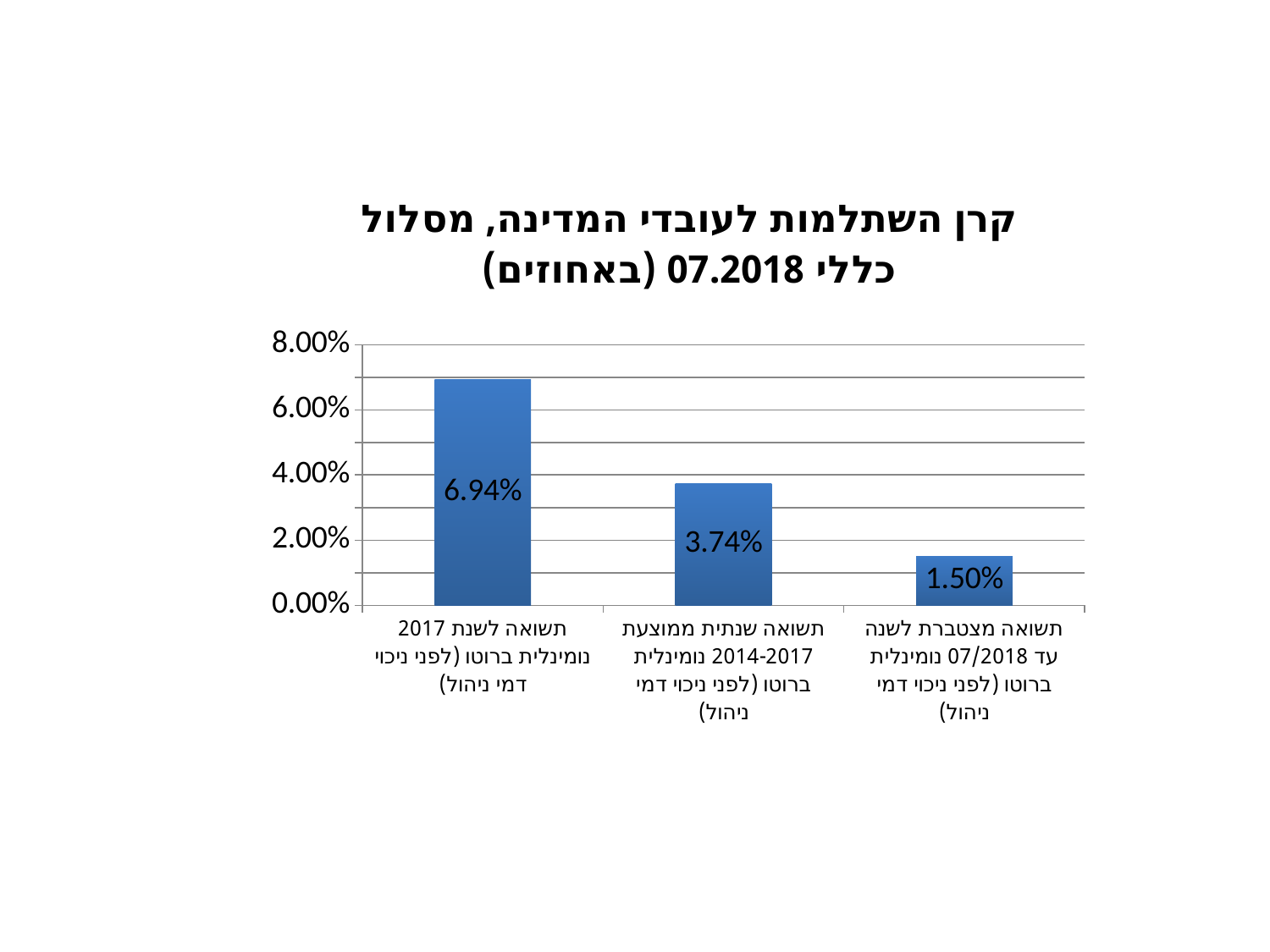
What is the value for the 2017 nominal gross return (תשואה לשנת 2017)? 6.94% Is the value for the 2017 return greater or less than 6.00%? greater How many categories are shown in the chart? 3 What is the difference between the 2017 return (6.94%) and the average annual return 2014-2017 (3.74%)? 3.20% What is the value for the cumulative return for the year to 07/2018 (תשואה מצטברת לשנה עד 07/2018)? 1.50% What is the difference between the average annual return 2014-2017 and the cumulative return to 07/2018? 2.24% Which category has the highest value? תשואה לשנת 2017 נומינלית ברוטו (לפני ניכוי דמי ניהול) What kind of chart is shown on the slide? Bar chart What is the title of the chart? קרן השתלמות לעובדי המדינה, מסלול כללי 07.2018 (באחוזים) Which is larger: the 2017 return or the cumulative return to 07/2018? The 2017 return (6.94%) What is the value for the average annual nominal gross return 2014-2017 (תשואה שנתית ממוצעת 2014-2017)? 3.74% Which category has the lowest value? תשואה מצטברת לשנה עד 07/2018 נומינלית ברוטו (לפני ניכוי דמי ניהול)